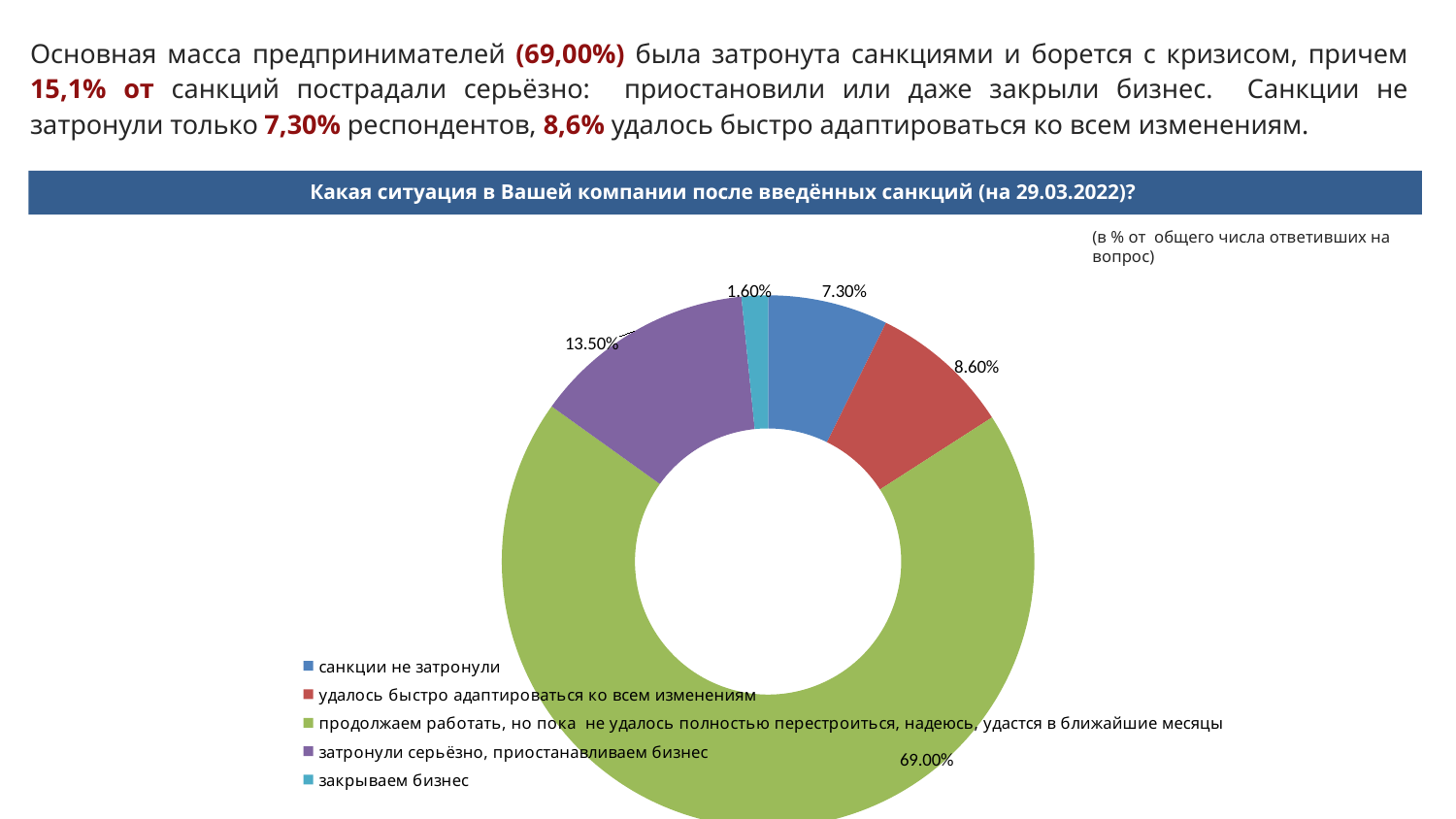
How many categories does the chart show? 5 Which category has the smallest share of the chart? закрываем бизнес What colour is the slice for "закрываем бизнес"? Light blue (cyan) What is the value for "закрываем бизнес"? 1.60% What is the difference between the values for "затронули серьёзно, приостанавливаем бизнес" and "санкции не затронули"? 6.20% What type of chart is shown on the slide? Doughnut (pie) chart Which category has the largest share of the chart? продолжаем работать, но пока не удалось полностью перестроиться, надеюсь, удастся в ближайшие месяцы What is the value for "затронули серьёзно, приостанавливаем бизнес"? 13.50% Which is larger: the value for "удалось быстро адаптироваться ко всем изменениям" or the value for "санкции не затронули"? удалось быстро адаптироваться ко всем изменениям What is the title of the chart? Какая ситуация в Вашей компании после введённых санкций (на 29.03.2022)? What is the value for "санкции не затронули"? 7.30% What is the value for "удалось быстро адаптироваться ко всем изменениям"? 8.60%